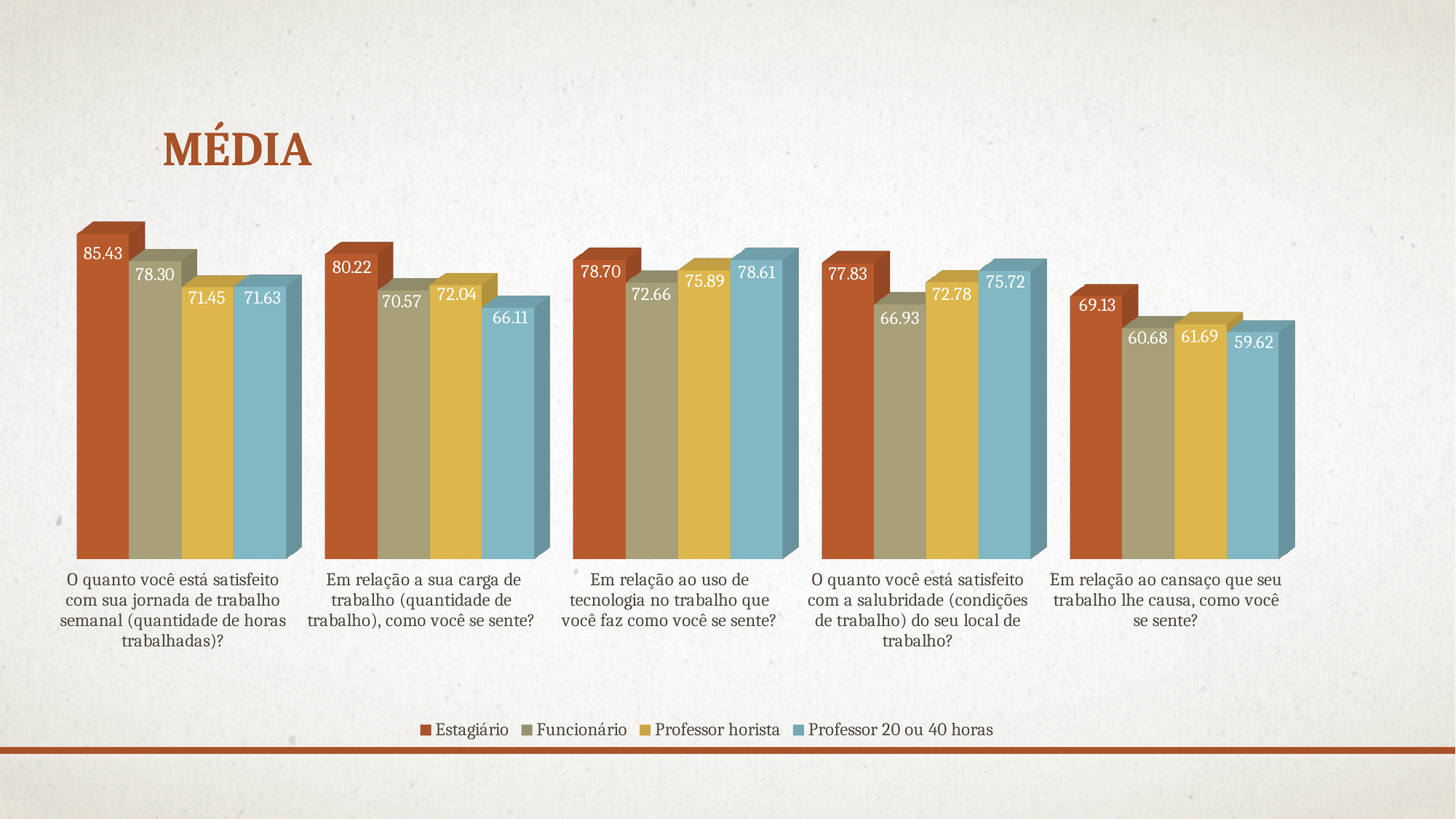
How many categories (questions) are shown on the x axis of the chart? 5 What is the value for Funcionário in the category about the tiredness (cansaço) caused by work? 60.68 What is the value for Professor 20 ou 40 horas in the category about workload (carga de trabalho)? 66.11 What is the value for Estagiário in the category about satisfaction with the weekly working hours (jornada de trabalho semanal)? 85.43 What kind of chart is shown on the slide? Bar chart Which series has the lowest value in the category about the tiredness (cansaço) caused by work? Professor 20 ou 40 horas What is the value for Professor horista in the category about the use of technology at work? 75.89 What is the difference between the Estagiário and Funcionário values in the category about satisfaction with the weekly working hours? 7.13 In which category does the Estagiário series reach its highest value? O quanto você está satisfeito com sua jornada de trabalho semanal (quantidade de horas trabalhadas)? How many series does the legend list? 4 What is the difference between the Estagiário and Professor 20 ou 40 horas values in the category about workload (carga de trabalho)? 14.11 In the category about salubrity (salubridade) of the workplace, which is larger: the Funcionário value or the Professor horista value? Professor horista